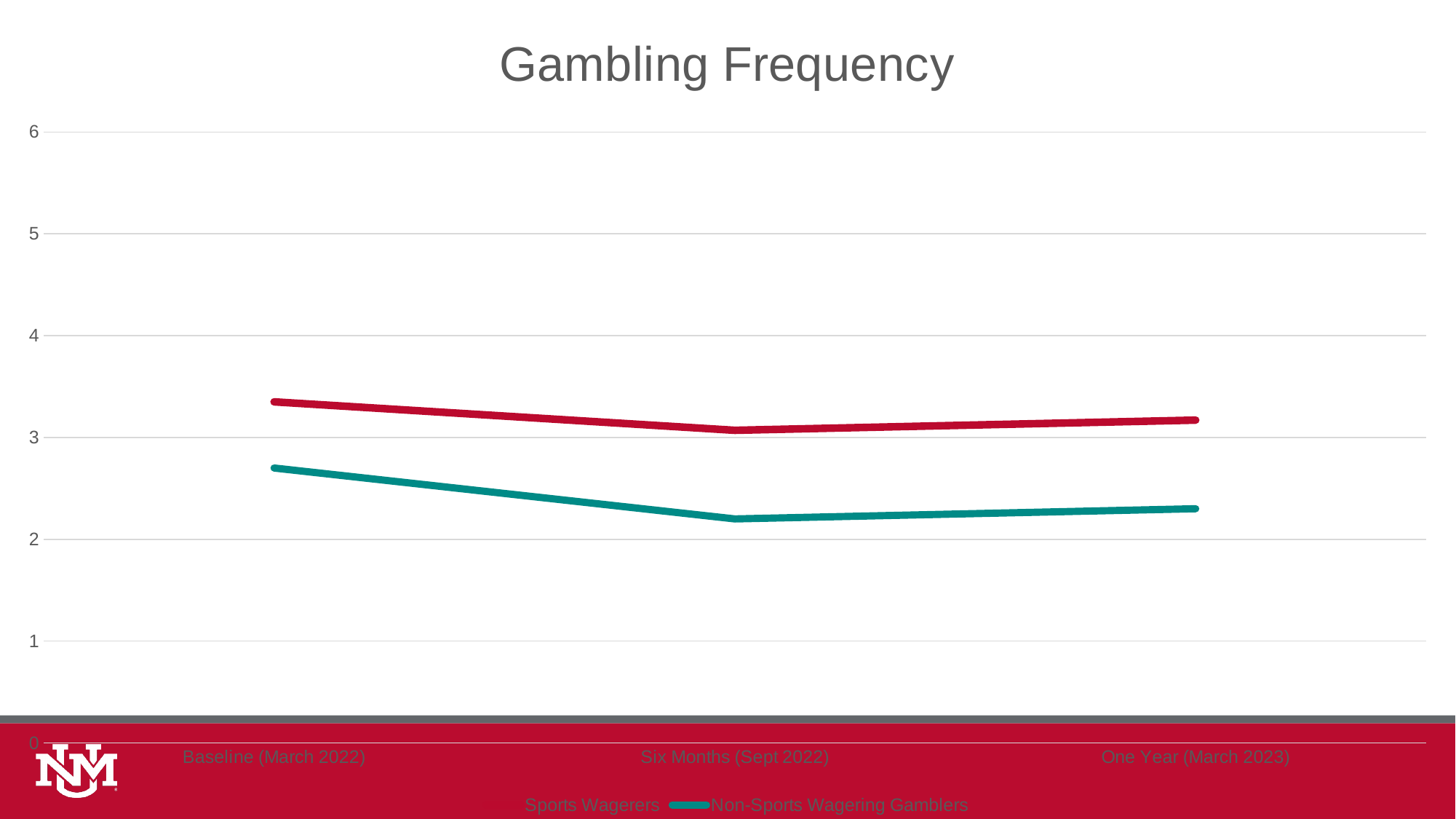
At which time point is the Non-Sports Wagering Gamblers series lowest? Six Months (Sept 2022) At Baseline (March 2022), which series has the higher value: Sports Wagerers or Non-Sports Wagering Gamblers? Sports Wagerers How many time points are plotted along the x axis? 3 What is the title of the chart? Gambling Frequency At which time point is the Sports Wagerers series highest? Baseline (March 2022) How many series does the legend list? 2 What kind of chart is shown on the slide? line chart Which series is drawn in teal? Non-Sports Wagering Gamblers Does the Non-Sports Wagering Gamblers series rise or fall from Baseline (March 2022) to Six Months (Sept 2022)? fall Is the value for Sports Wagerers at Baseline (March 2022) greater or less than 3? greater Is the value for Non-Sports Wagering Gamblers at Six Months (Sept 2022) greater or less than 2? greater Is the value for Non-Sports Wagering Gamblers at Baseline (March 2022) greater or less than 3? less